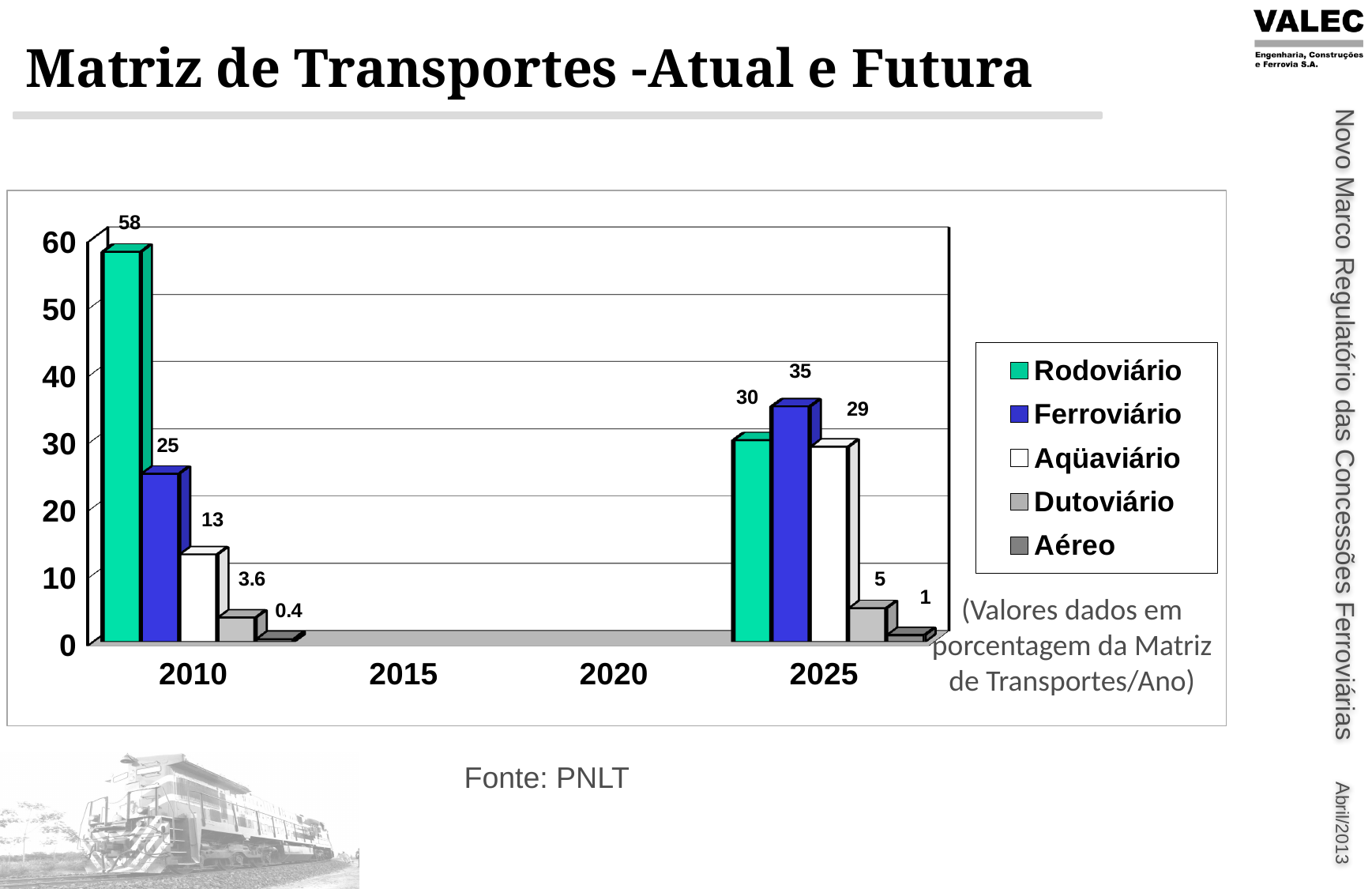
Does the Ferroviário value rise or fall from 2010 to 2025? Rise Which series has the lowest value in 2025? Aéreo Which series has the highest value in 2010? Rodoviário How many series does the legend list? 5 What kind of chart is shown on the slide? Bar chart What is the value for Rodoviário in 2010? 58 What is the value for Dutoviário in 2025? 5 Which is larger in 2025, Ferroviário or Aqüaviário? Ferroviário What is the source cited below the chart? PNLT What is the value for Ferroviário in 2025? 35 What is the difference between the Rodoviário values for 2010 and 2025? 28 What is the value for Aéreo in 2010? 0.4